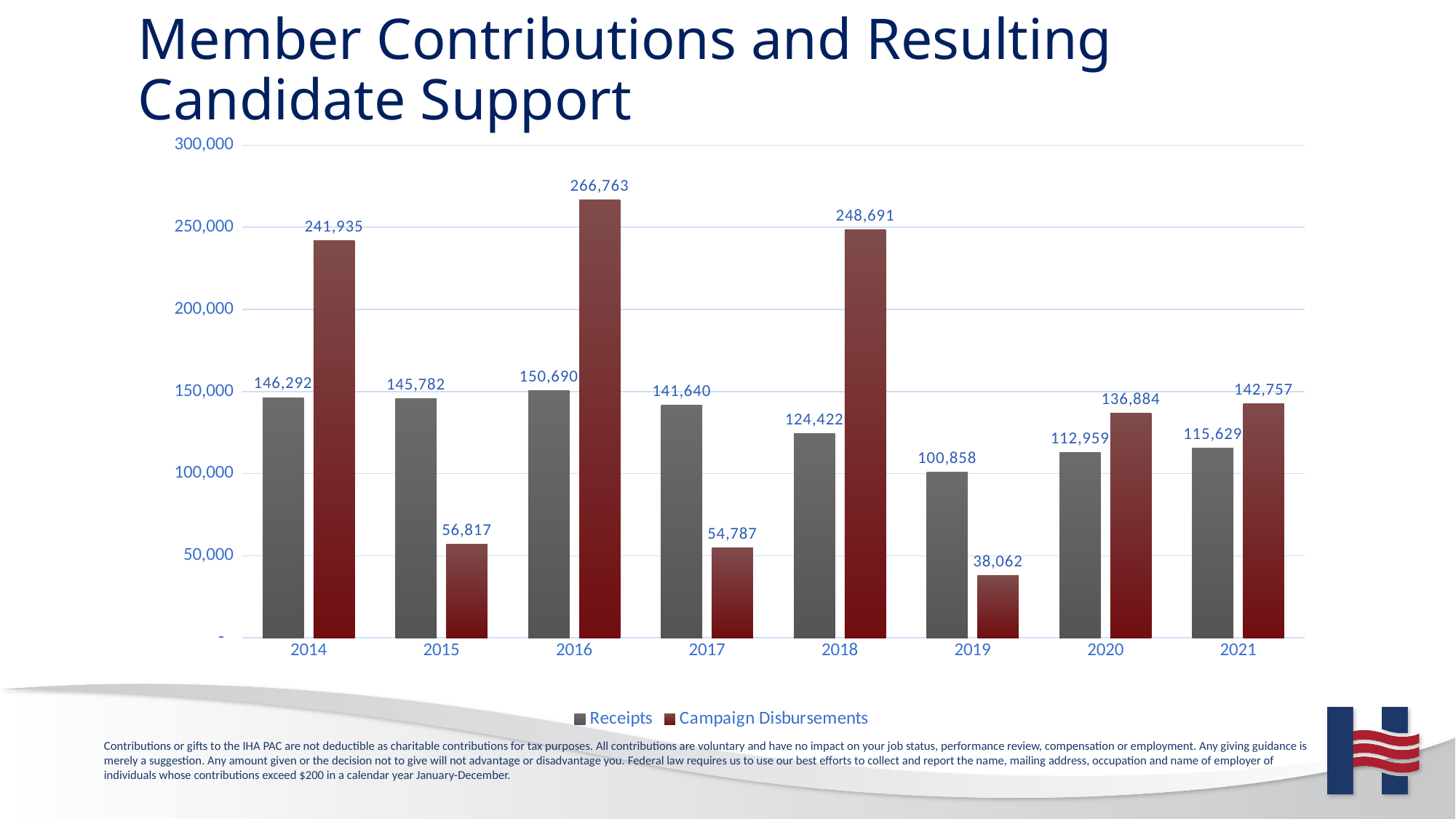
What is the value of Receipts for 2014? 146,292 Is the value of Campaign Disbursements for 2018 greater or less than 200,000? greater Which year has the lowest Receipts? 2019 What is the value of Campaign Disbursements for 2016? 266,763 What kind of chart is shown on the slide? Bar chart What is the value of Campaign Disbursements for 2019? 38,062 Which is larger in 2017, Receipts or Campaign Disbursements? Receipts How many years are shown on the x axis? 8 Which year has the highest Campaign Disbursements? 2016 What is the value of Receipts for 2021? 115,629 How many series does the legend list? 2 What is the difference between Campaign Disbursements and Receipts in 2016? 116,073